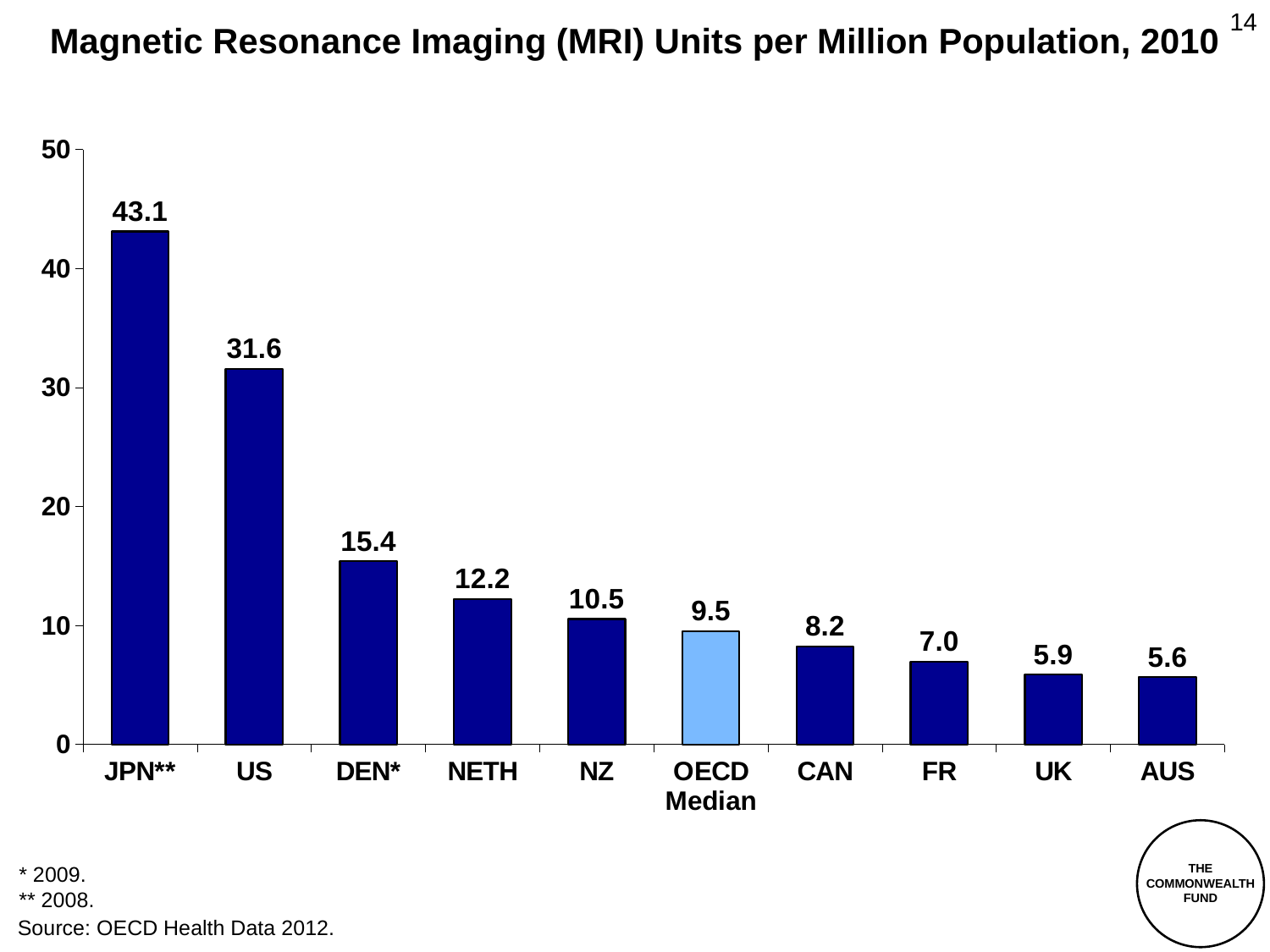
What kind of chart is this? bar chart Is the value for FR greater or less than 10? less What is the difference between the values for CAN and the OECD Median? 1.3 What is the difference between the values for JPN** and the US? 11.5 What is the value for NETH? 12.2 How many categories are shown on the x axis? 10 What is the value for the US? 31.6 Which category has the lowest value? AUS What is the value for the OECD Median? 9.5 Which category has the highest value? JPN** Which is larger, the value for DEN* or the value for NZ? DEN* Which bar is shown in a lighter blue colour than the others? OECD Median